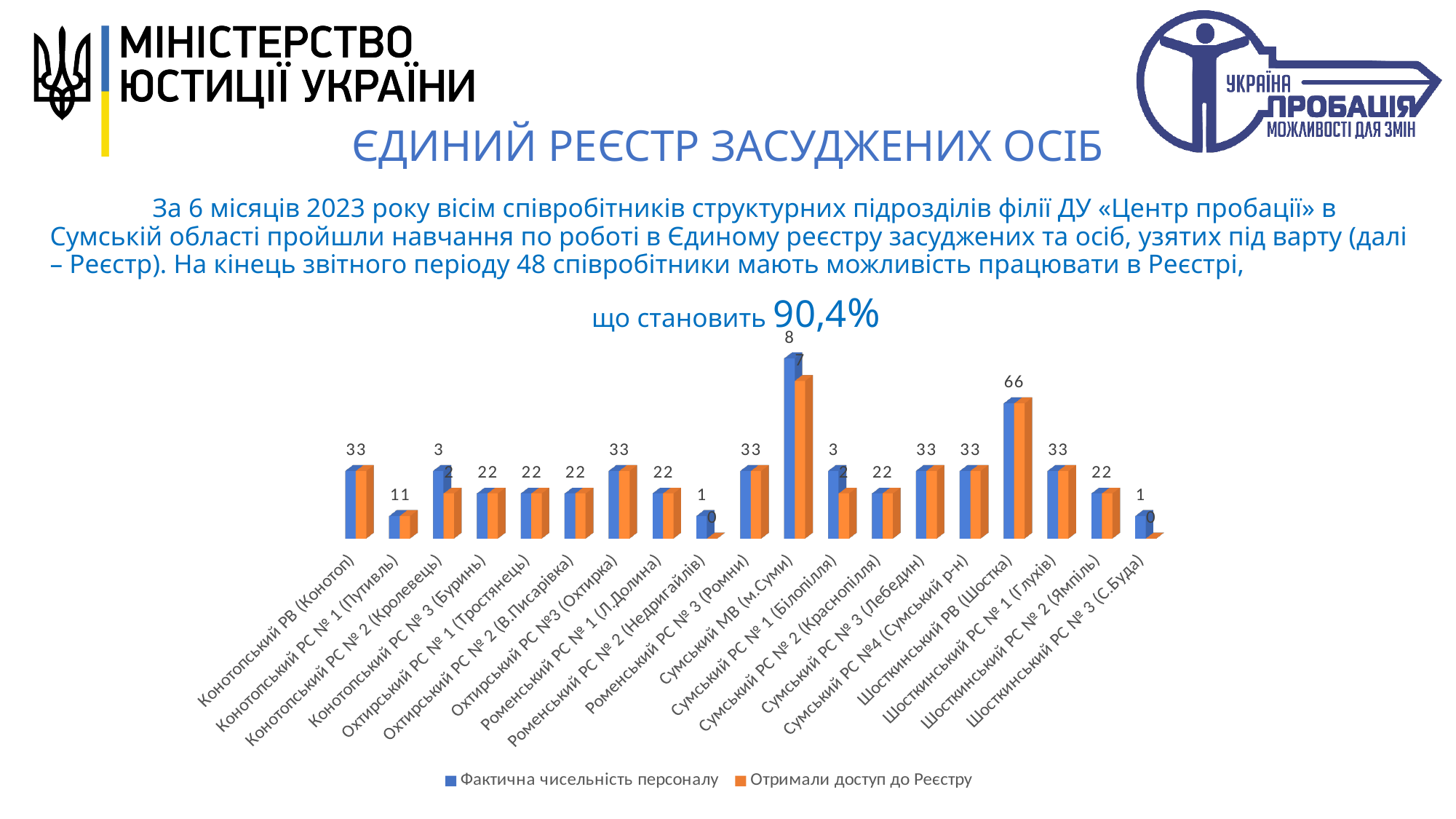
What is the value of "Фактична чисельність персоналу" for Шосткинський РВ (Шостка)? 6 How many series does the chart legend list? 2 What is the value of "Отримали доступ до Реєстру" for Сумський МВ (м.Суми)? 7 Which is larger: "Фактична чисельність персоналу" for Шосткинський РВ (Шостка) or for Конотопський РВ (Конотоп)? Шосткинський РВ (Шостка) What is the value of "Отримали доступ до Реєстру" for Роменський РС № 2 (Недригайлів)? 0 What kind of chart is shown on the slide? Bar chart Which category has the highest value of "Фактична чисельність персоналу"? Сумський МВ (м.Суми) What is the value of "Фактична чисельність персоналу" for Сумський МВ (м.Суми)? 8 How many categories are shown on the x axis of the chart? 19 What is the difference between "Фактична чисельність персоналу" and "Отримали доступ до Реєстру" for Сумський РС № 1 (Білопілля)? 1 Which colour represents the series "Отримали доступ до Реєстру" in the chart? Orange What is the difference between "Фактична чисельність персоналу" for Сумський МВ (м.Суми) and for Шосткинський РВ (Шостка)? 2